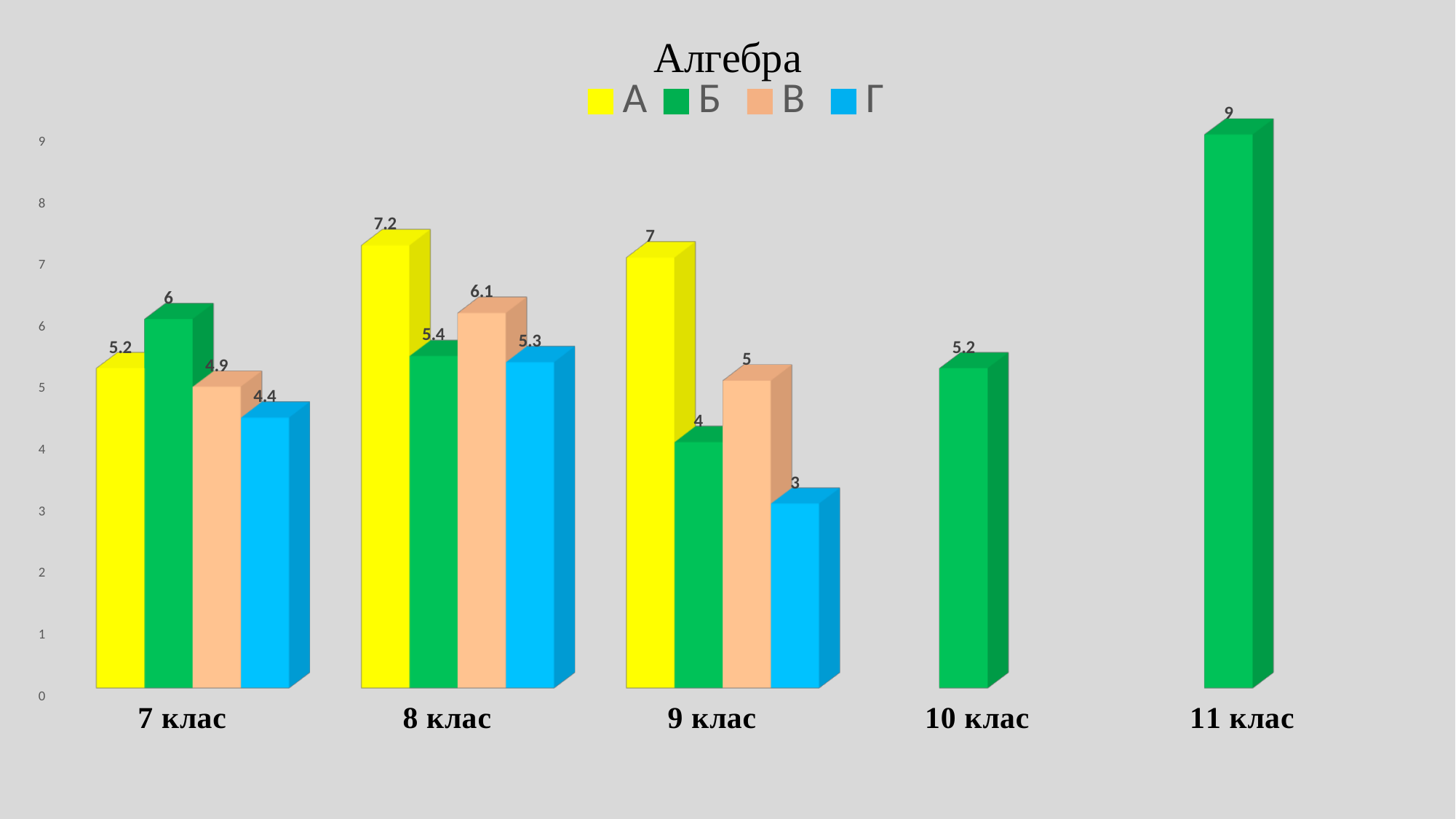
Which category has the highest value for series Б? 11 клас How many categories are shown on the x axis? 5 What is the value for series Г in 9 клас? 3 What is the value for series А in 8 клас? 7.2 Which is larger in 7 клас: series А or series Б? Б How many series does the legend list? 4 Which series has the lowest value in 9 клас? Г What kind of chart is shown? bar chart What is the title of the chart? Алгебра What is the value for series Б in 11 клас? 9 What is the value for series В in 7 клас? 4.9 What is the difference between series А and series Б in 8 клас? 1.8